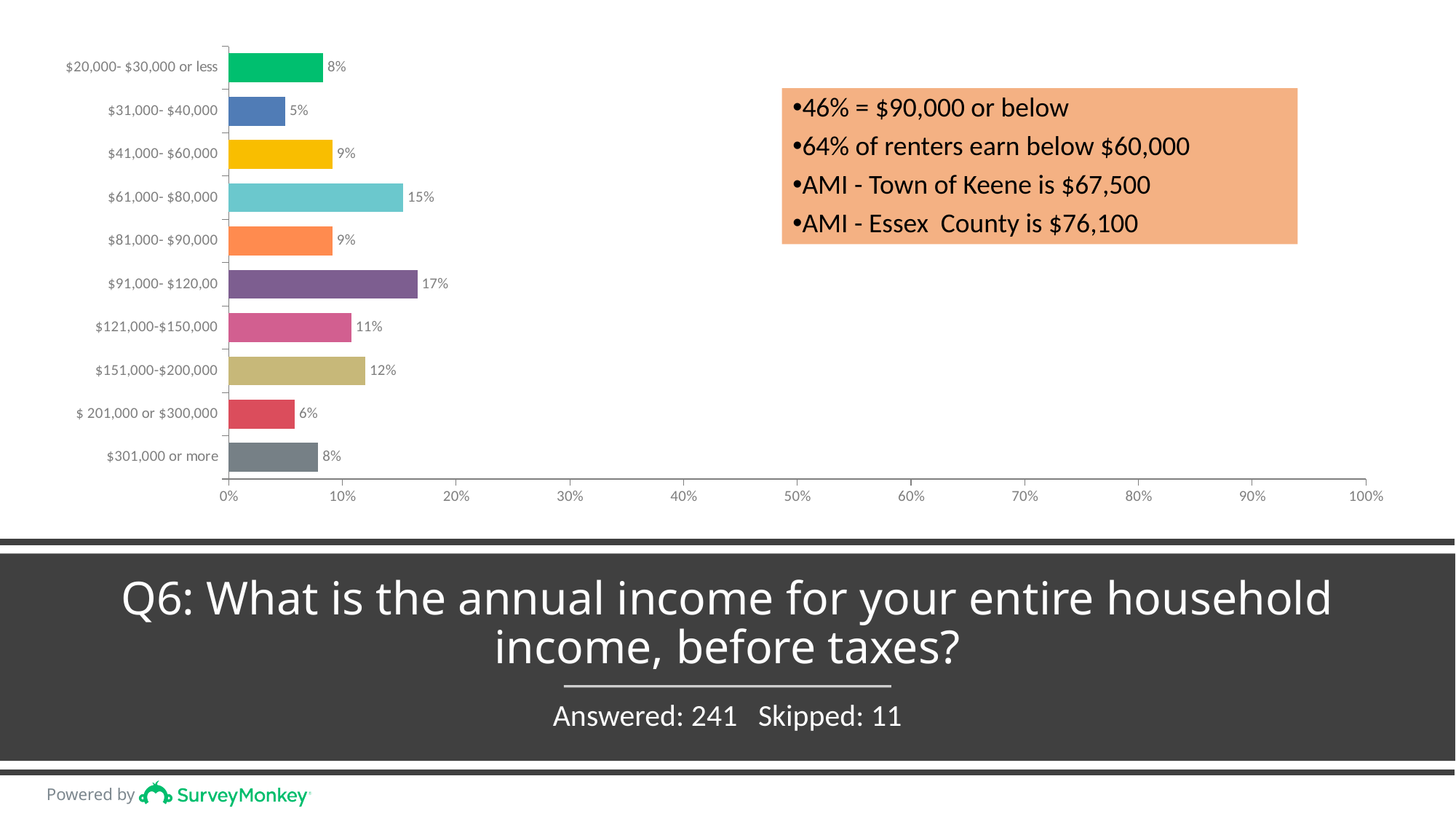
What is the difference in percentage points between the $91,000-$120,00 category and the $121,000-$150,000 category? 6 Which category has a larger percentage: $41,000-$60,000 or $201,000 or $300,000? $41,000-$60,000 What percentage of respondents reported a household income of $61,000-$80,000? 15% What type of chart is shown on the slide? bar chart Which income category has the highest percentage of respondents? $91,000-$120,00 What percentage of respondents reported a household income of $31,000-$40,000? 5% How many income categories are shown in the chart? 10 Which income category has the lowest percentage of respondents? $31,000-$40,000 How many respondents answered the question according to the slide? 241 What percentage of respondents reported a household income of $151,000-$200,000? 12% Is the value for $61,000-$80,000 greater or less than 10%? greater What is the combined percentage for the $20,000-$30,000 or less and $301,000 or more categories? 16%